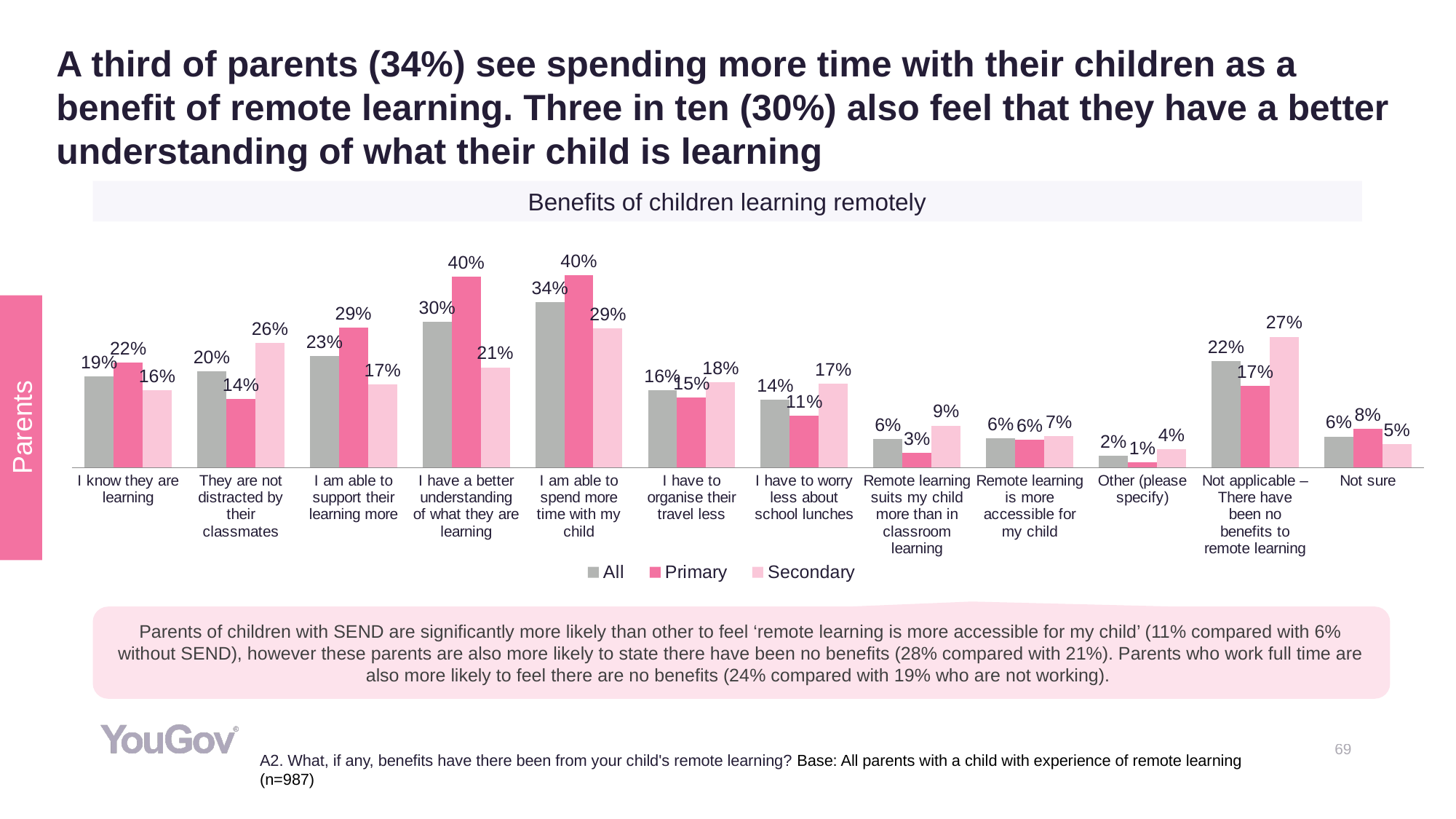
How many categories are shown on the x axis of the chart? 12 For 'I am able to support their learning more', which is larger: the Primary value or the Secondary value? Primary How many series does the legend list? 3 Which category has the highest value for the All series? I am able to spend more time with my child What type of chart is shown on the slide? Bar chart What percentage of all parents say 'I am able to spend more time with my child' is a benefit of remote learning? 34% What is the Primary value for 'I have a better understanding of what they are learning'? 40% What is the title of the chart? Benefits of children learning remotely Which category has the lowest value for the Primary series? Other (please specify) What is the difference between the Secondary and Primary values for 'Not applicable – There have been no benefits to remote learning'? 10 percentage points What is the Secondary value for 'They are not distracted by their classmates'? 26% What is the difference between the Primary and Secondary values for 'I have a better understanding of what they are learning'? 19 percentage points